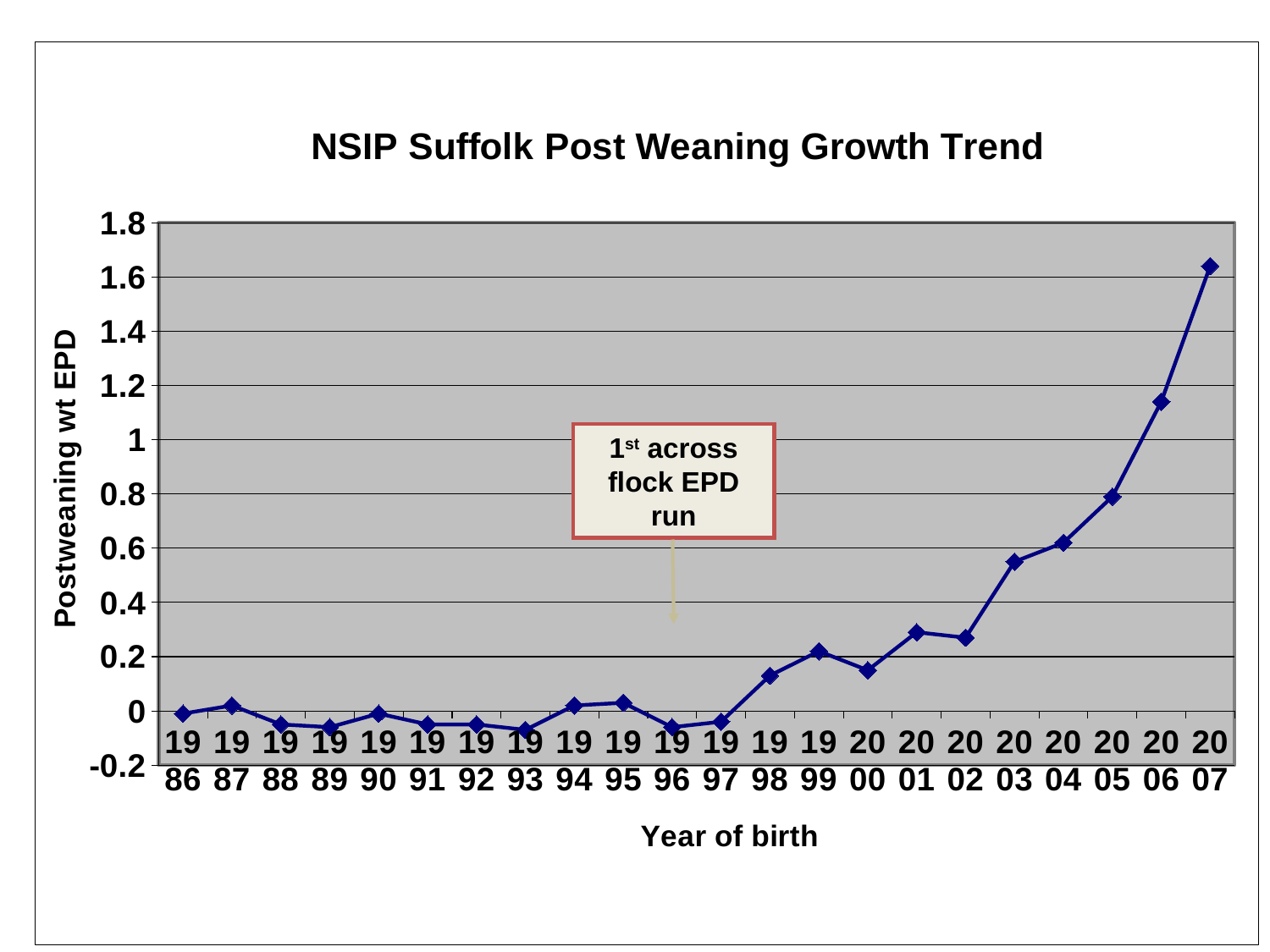
What kind of chart is shown on the slide? line chart Which has the larger postweaning wt EPD, 2003 or 1999? 2003 Is the value for 2003 greater or less than 0.4? greater What is the label on the x axis of the chart? Year of birth Which year of birth has the highest postweaning wt EPD? 2007 Is the value for 2005 greater or less than 1? less Is the value for 2006 greater or less than 1? greater How many years of birth are plotted on the chart? 22 Do the values generally rise or fall from 1997 to 2007? rise Which has the larger postweaning wt EPD, 2006 or 2007? 2007 What is the title of the chart? NSIP Suffolk Post Weaning Growth Trend